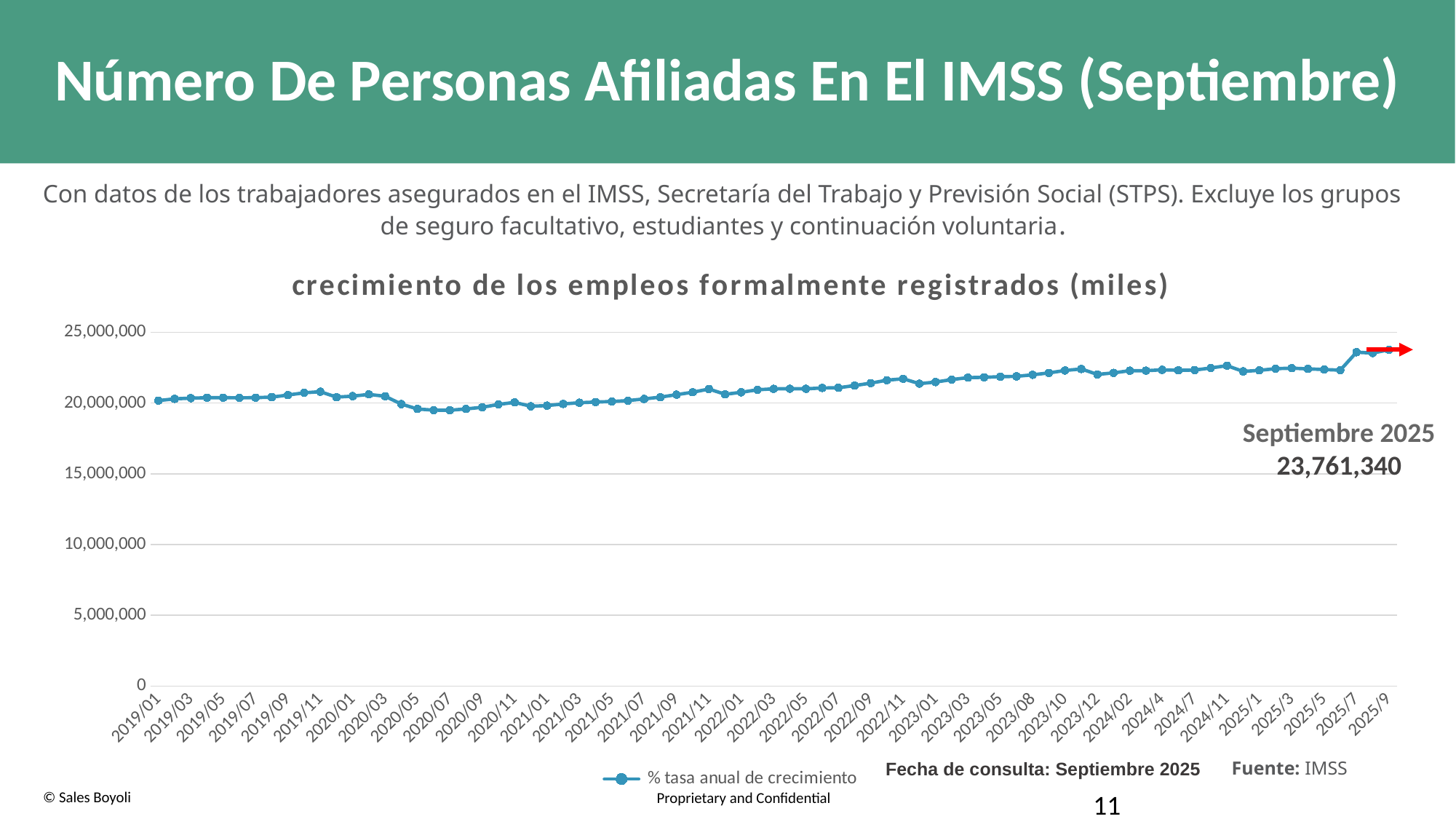
What is the title of the chart? crecimiento de los empleos formalmente registrados (miles) Is the value for 2023/12 greater or less than 20,000,000? greater What is the highest tick value shown on the y axis? 25,000,000 Is the value for 2020/07 greater or less than 20,000,000? less What kind of chart is shown on the slide? line chart How many series does the chart legend list? 1 Overall, do the values rise or fall from 2019/01 to 2025/9? rise Which is larger, the value for 2020/07 or the value for 2025/9? 2025/9 What is the legend entry for the plotted series? % tasa anual de crecimiento Which is larger, the value for 2019/01 or the value for 2023/12? 2023/12 Is the value for 2025/9 greater or less than 25,000,000? less What value is annotated for Septiembre 2025? 23,761,340